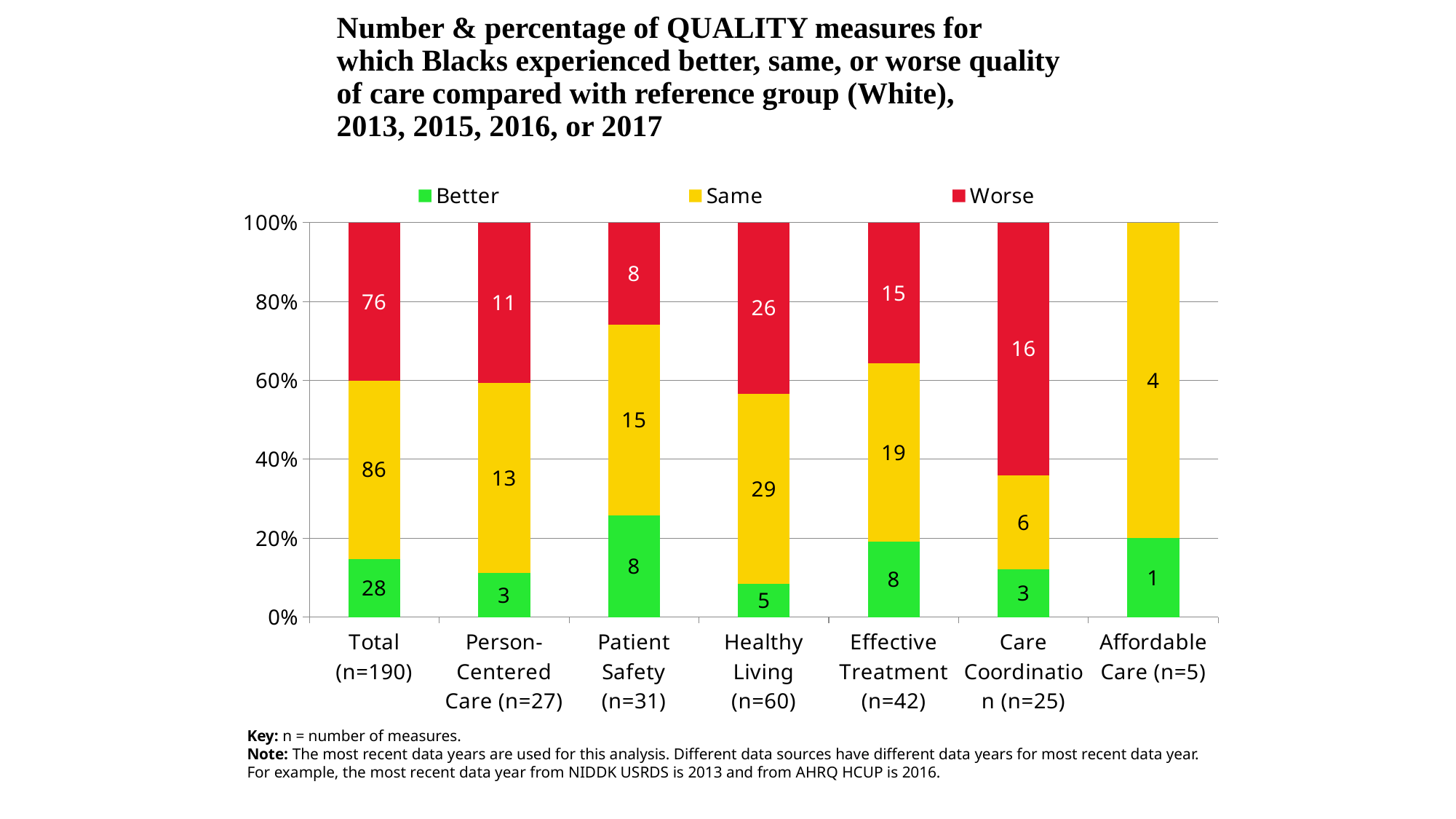
Is the Better share of the Patient Safety (n=31) bar greater or less than 20%? greater What kind of chart is shown on the slide? stacked bar chart Which category has the highest Worse value? Total (n=190) What is the difference between the Same and Worse values for Person-Centered Care (n=27)? 2 What is the Same value for Effective Treatment (n=42)? 19 What is the total of the Better, Same and Worse values for Effective Treatment (n=42)? 42 What is the Worse value for Healthy Living (n=60)? 26 What is the Better value for Care Coordination (n=25)? 3 Which is larger for Care Coordination (n=25), the Same value or the Worse value? Worse Which category has the lowest Better value? Affordable Care (n=5) How many series does the legend list? 3 How many categories are shown along the x axis? 7